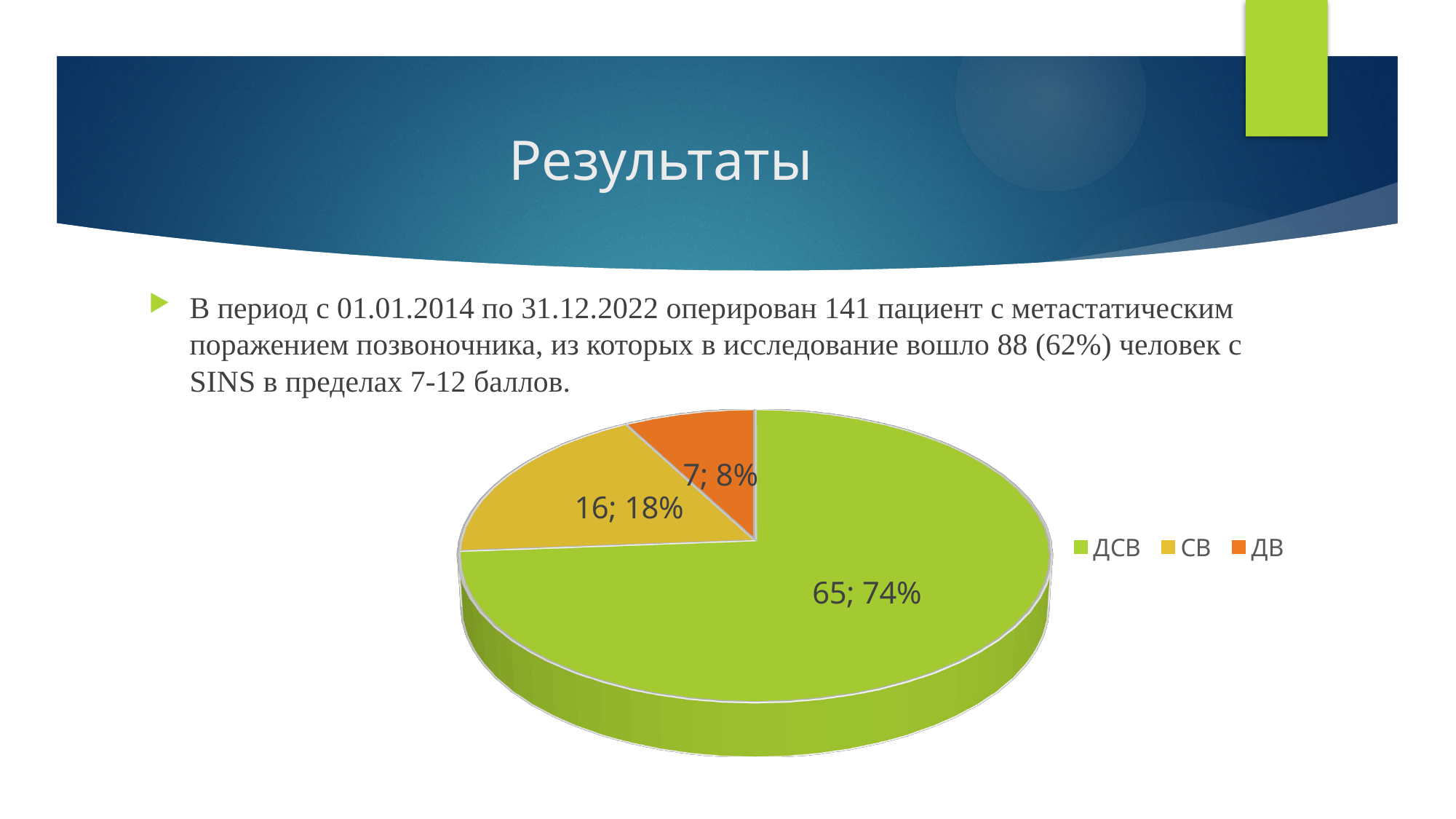
Which category has the largest slice? ДСВ What is the difference between the values for ДСВ and СВ? 49 How many slices does the pie chart have? 3 What is the value shown for СВ? 16 What share of the pie does ДСВ represent? 74% What kind of chart is shown on the slide? pie chart What share of the pie does СВ represent? 18% What share of the pie does ДВ represent? 8% What is the value shown for ДВ? 7 How many entries does the legend list? 3 What is the value shown for ДСВ? 65 Which category has the smallest slice? ДВ